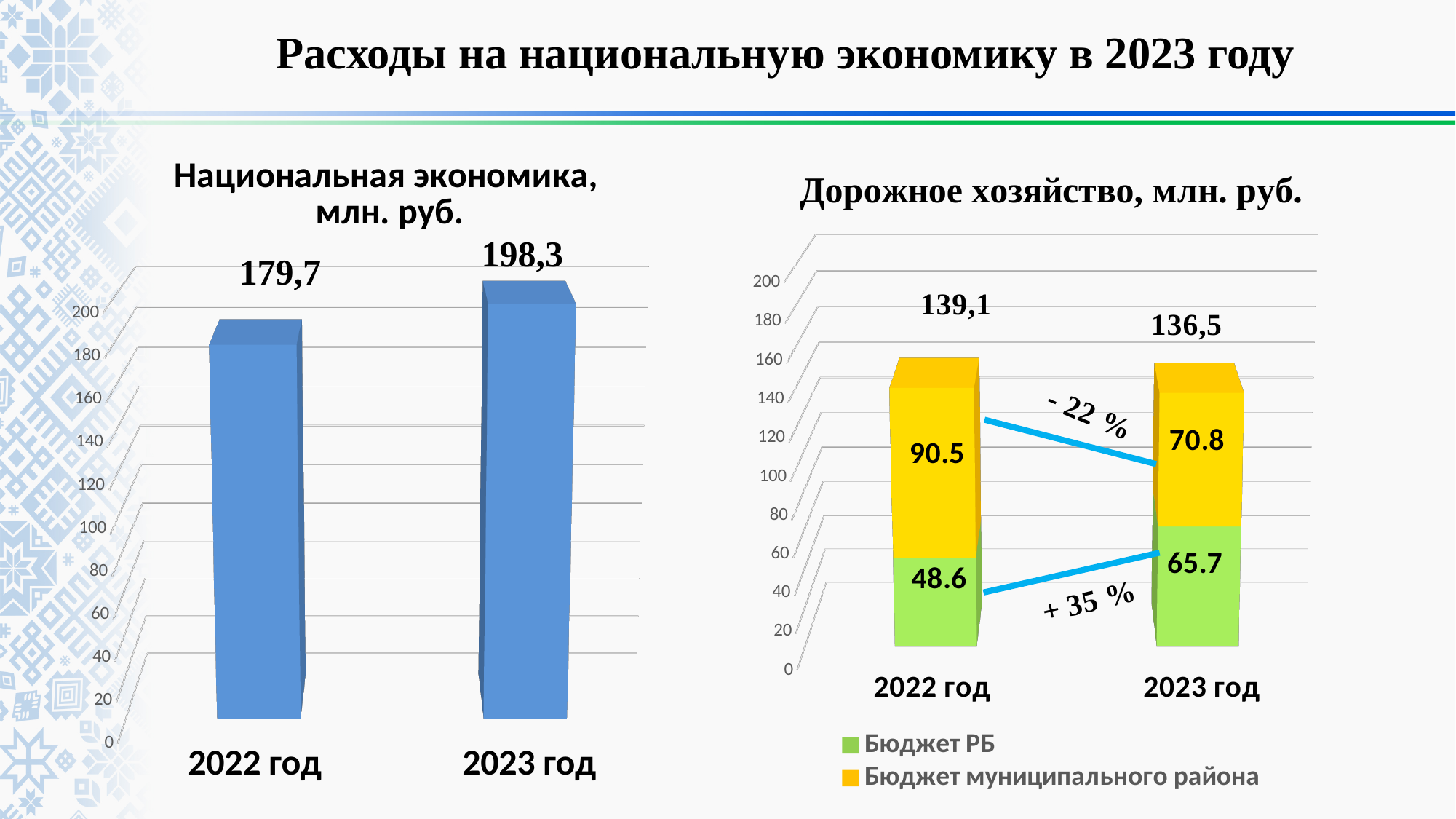
In the chart titled 'Дорожное хозяйство, млн. руб.', which is larger for 2023 год: Бюджет РБ or Бюджет муниципального района? Бюджет муниципального района In the chart titled 'Дорожное хозяйство, млн. руб.', what colour represents Бюджет РБ in the legend? green In the chart titled 'Национальная экономика, млн. руб.', what is the value for 2022 год? 179,7 In the chart titled 'Дорожное хозяйство, млн. руб.', what is the total of the stacked bar for 2023 год? 136,5 In the chart titled 'Национальная экономика, млн. руб.', what is the value for 2023 год? 198,3 In the chart titled 'Дорожное хозяйство, млн. руб.', what is the value of Бюджет муниципального района for 2023 год? 70.8 In the chart titled 'Дорожное хозяйство, млн. руб.', what is the total of the stacked bar for 2022 год? 139,1 In the chart titled 'Национальная экономика, млн. руб.', by how much does the 2023 год value exceed the 2022 год value? 18,6 In the chart titled 'Дорожное хозяйство, млн. руб.', how many series does the legend list? 2 In the chart titled 'Национальная экономика, млн. руб.', which year has the higher value? 2023 год In the chart titled 'Национальная экономика, млн. руб.', do the values rise or fall from 2022 год to 2023 год? rise In the chart titled 'Дорожное хозяйство, млн. руб.', what is the value of Бюджет РБ for 2022 год? 48.6